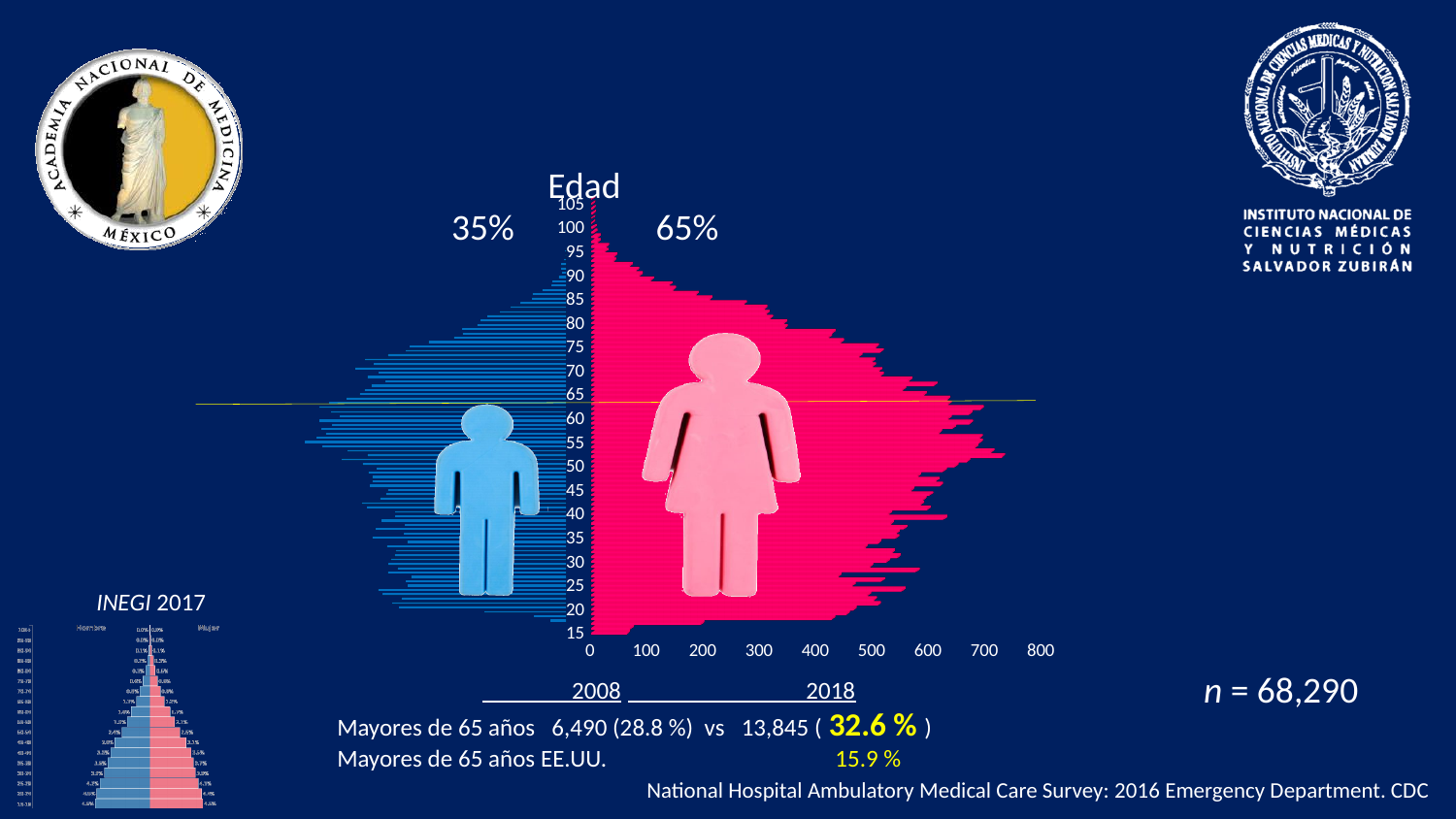
What percentage is shown above the pink (right) side of the central chart? 65% What kind of chart is the large chart in the centre of the slide? Bar chart (population pyramid) What is the sample size n stated on the slide? 68,290 What percentage of patients over 65 years is given for 2018 on the slide? 32.6 % What is the title of the large central chart? Edad In the central chart, is the pink bar at age 25 greater or less than 400? greater What is the highest value labelled on the horizontal axis of the central chart? 800 In the central chart, do the pink bars get longer or shorter as age increases from 60 to 105? Shorter Which side of the central chart has the larger share, the blue side or the pink side? Pink side In the central chart, is the pink bar at age 90 greater or less than 100? less In the central chart, is the pink bar at age 55 greater or less than 600? greater What percentage is shown above the blue (left) side of the central chart? 35%